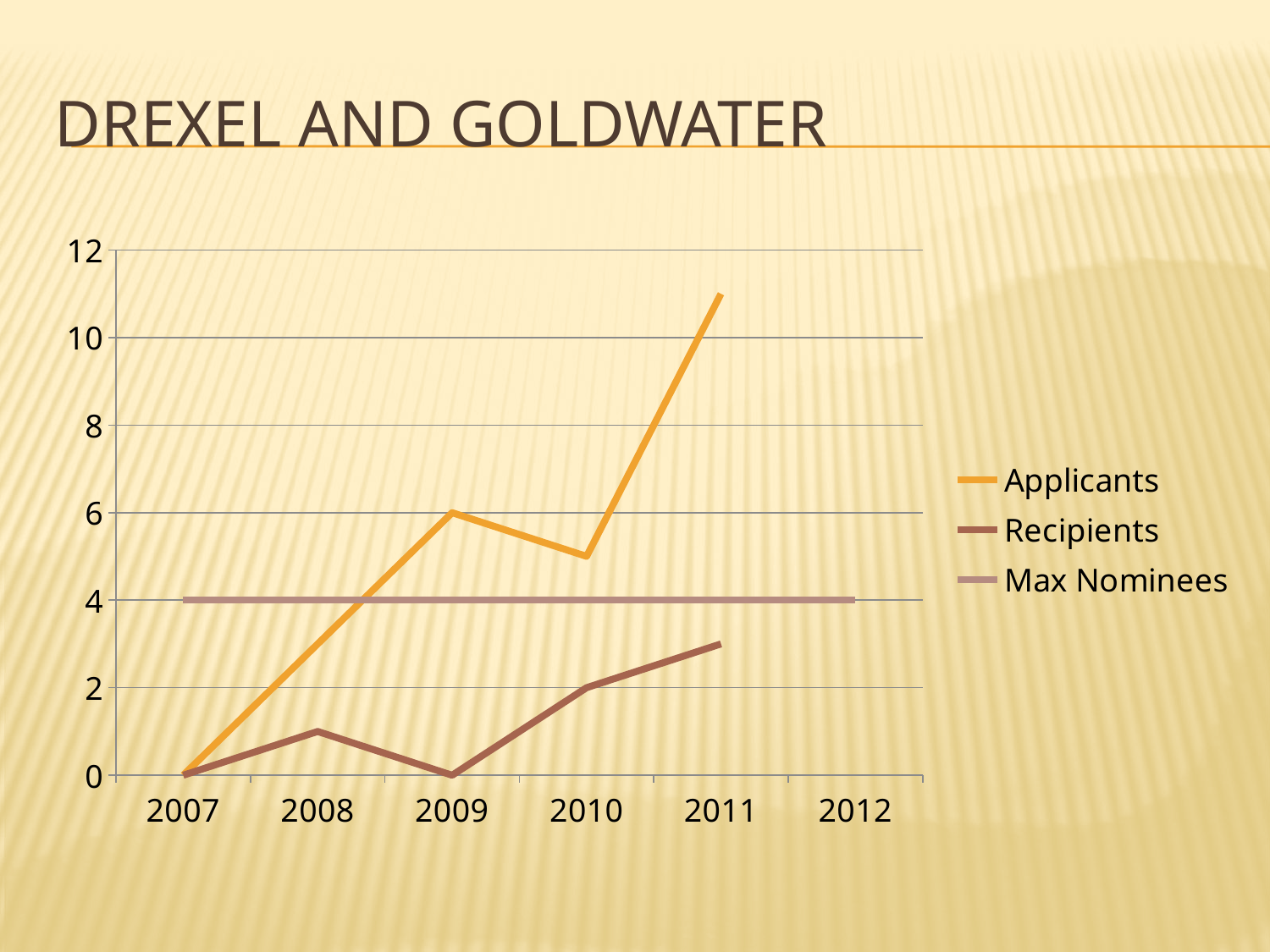
What is the value for Recipients in 2010? 2 Is the value for Applicants in 2011 greater or less than 10? greater How many series does the legend list? 3 Is the value for Recipients in 2011 greater or less than 4? less What kind of chart is shown on the slide? Line chart What is the value of the Max Nominees line? 4 What is the value for Applicants in 2009? 6 Which is larger, the Applicants value in 2009 or in 2010? 2009 How many years are labelled on the x axis? 6 In which year is the Applicants value highest? 2011 What is the difference between the Applicants value and the Recipients value in 2009? 6 In which year is the Applicants value lowest? 2007